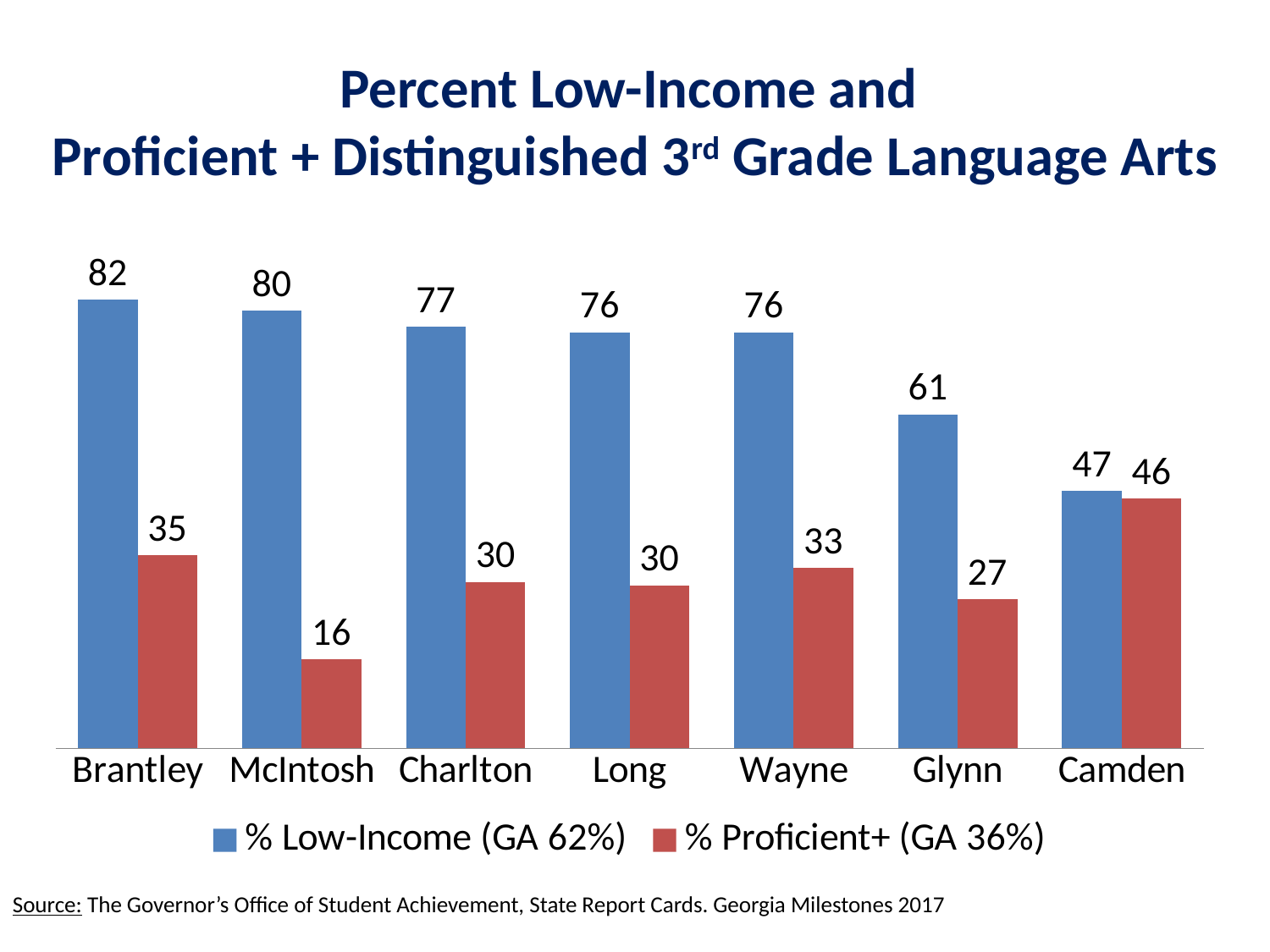
What Georgia statewide percentage is given in the legend for % Proficient+? 36% Which county has the lowest % Proficient+ value? McIntosh Do the % Low-Income values rise or fall from Brantley to Camden along the x axis? Fall What is the difference between the % Low-Income and % Proficient+ values for Glynn? 34 What is the % Low-Income value for Brantley? 82 What kind of chart is shown on the slide? Bar chart How many series does the legend list? 2 What is the % Proficient+ value for Camden? 46 Which county has the highest % Low-Income value? Brantley Which is larger, the % Proficient+ value for Wayne or for Long? Wayne How many counties are shown on the x axis? 7 What is the % Proficient+ value for McIntosh? 16